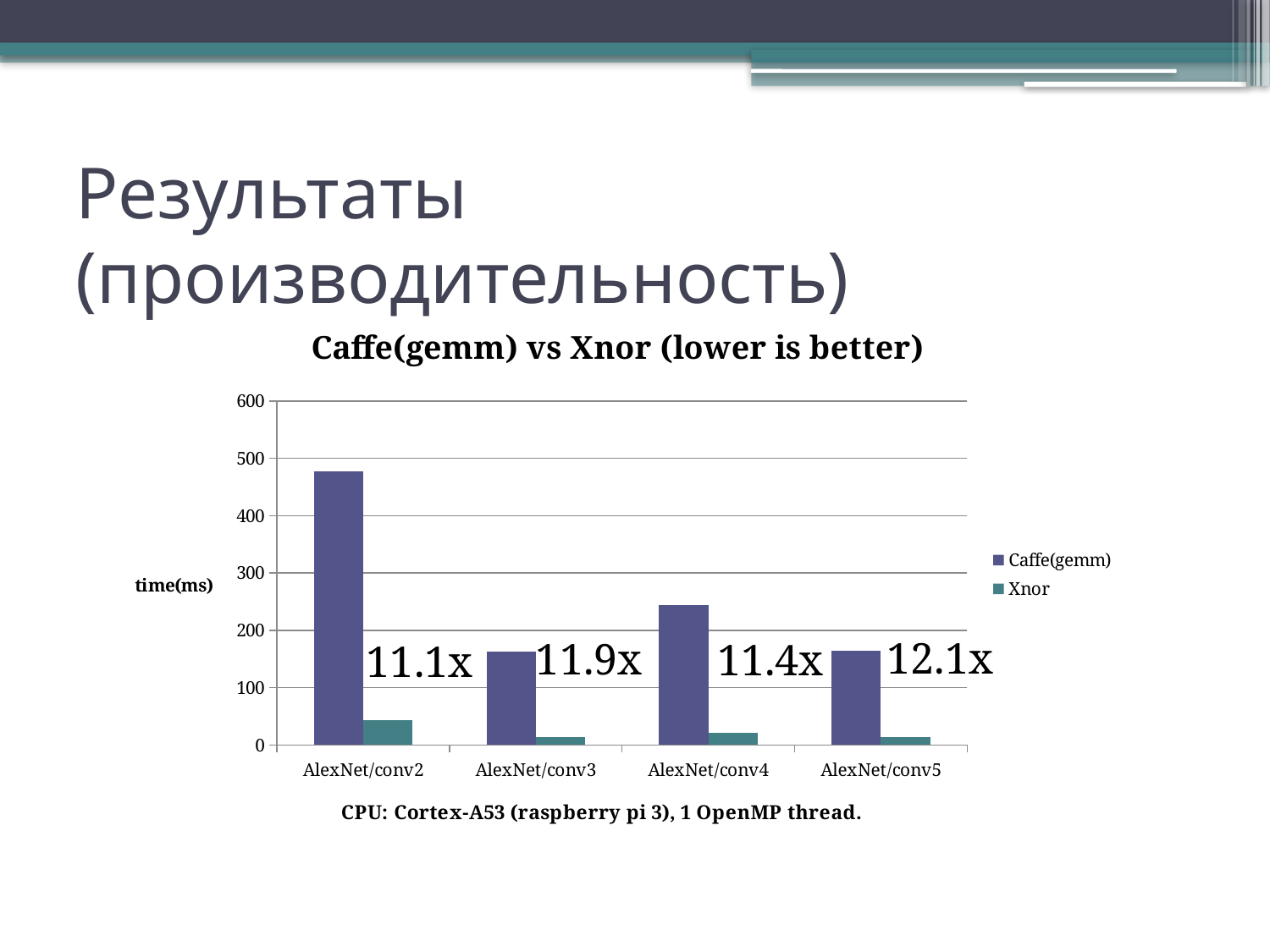
Is the Caffe(gemm) value for AlexNet/conv3 greater or less than 200? less Is the Caffe(gemm) value for AlexNet/conv2 greater or less than 400? greater Which category has the highest Caffe(gemm) value? AlexNet/conv2 How many series does the chart's legend list? 2 How many categories are shown on the x axis of the chart? 4 What is the title of the chart? Caffe(gemm) vs Xnor (lower is better) Is the Caffe(gemm) value for AlexNet/conv4 greater or less than 200? greater For AlexNet/conv4, which series has the larger value, Caffe(gemm) or Xnor? Caffe(gemm) Which is larger: the Caffe(gemm) value for AlexNet/conv2 or the Caffe(gemm) value for AlexNet/conv4? AlexNet/conv2 What kind of chart is shown on the slide? bar chart Which category has the highest Xnor value? AlexNet/conv2